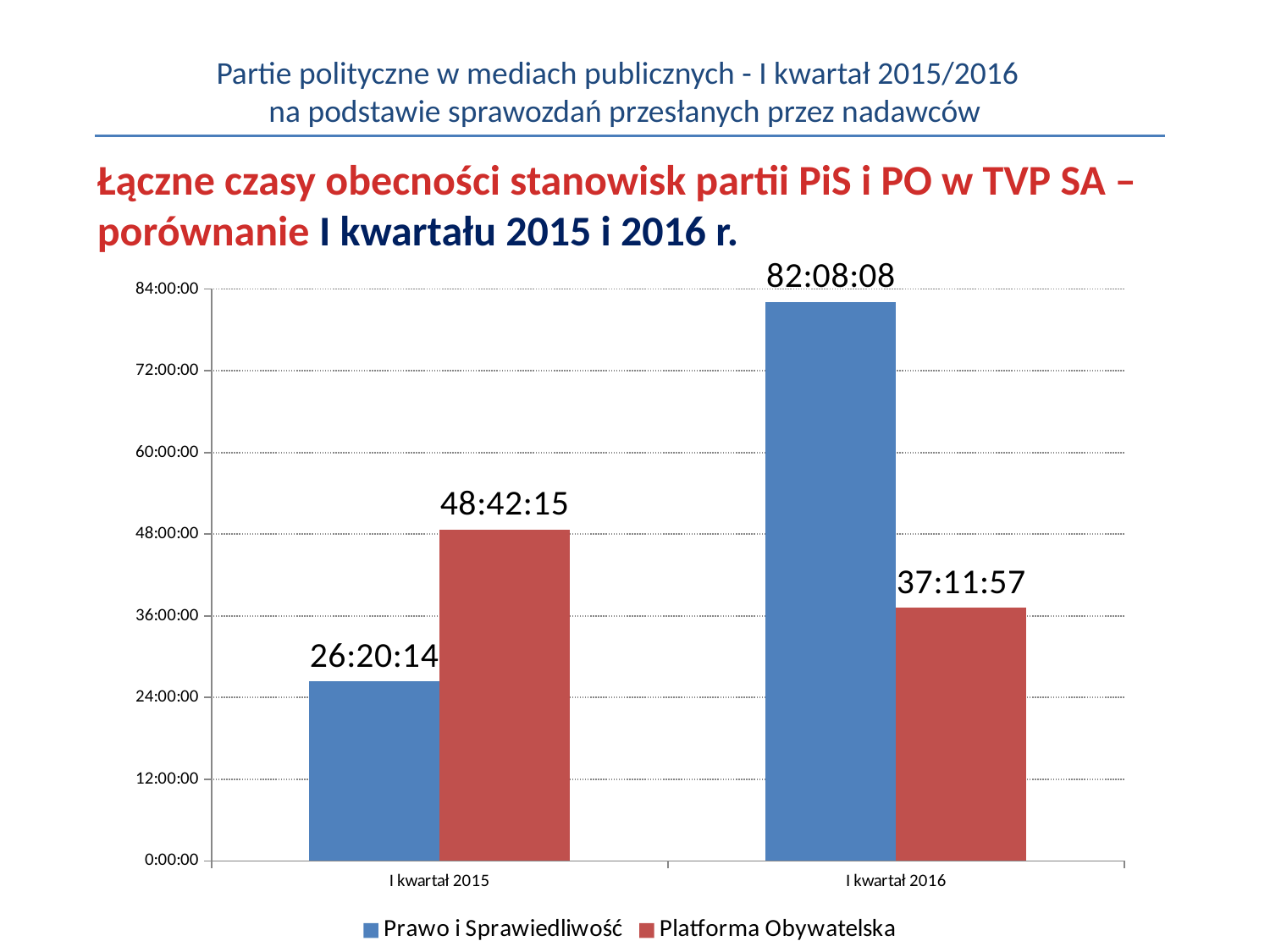
Which bar has the highest value on the chart? Prawo i Sprawiedliwość, I kwartał 2016 What is the value for Prawo i Sprawiedliwość in I kwartał 2016? 82:08:08 What kind of chart is shown on the slide? Bar chart What is the difference between Prawo i Sprawiedliwość and Platforma Obywatelska in I kwartał 2016? 44:56:11 Which party has the larger value in I kwartał 2015? Platforma Obywatelska How many series does the legend list? 2 Which bar has the lowest value on the chart? Prawo i Sprawiedliwość, I kwartał 2015 What is the value for Platforma Obywatelska in I kwartał 2016? 37:11:57 What is the value for Platforma Obywatelska in I kwartał 2015? 48:42:15 What is the value for Prawo i Sprawiedliwość in I kwartał 2015? 26:20:14 How many categories are shown on the x axis? 2 Which party has the larger value in I kwartał 2016? Prawo i Sprawiedliwość